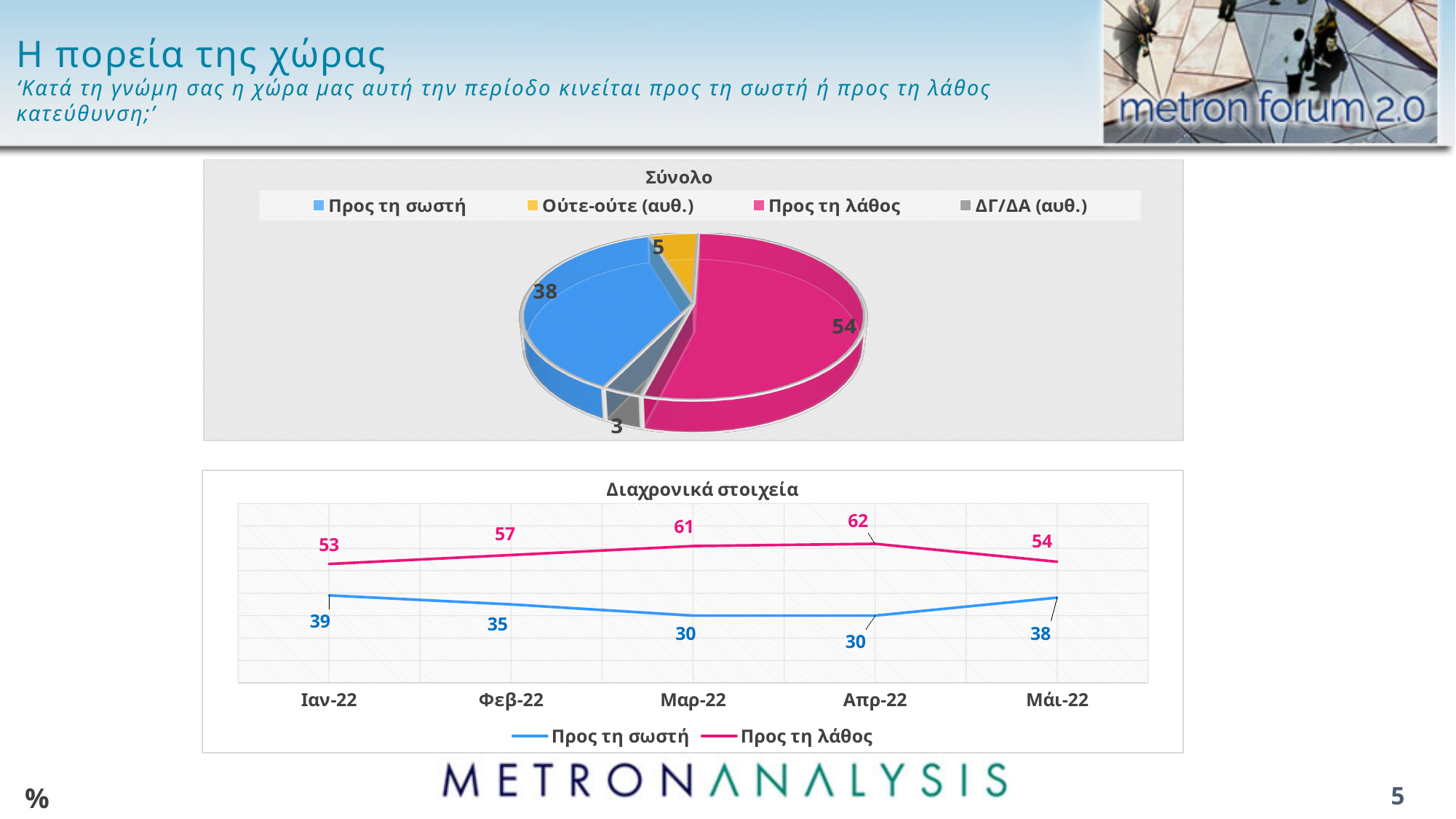
In the 'Διαχρονικά στοιχεία' chart, in which month does 'Προς τη λάθος' reach its highest value? Απρ-22 In the 'Διαχρονικά στοιχεία' chart, what is the value for 'Προς τη λάθος' in Απρ-22? 62 In the 'Διαχρονικά στοιχεία' chart, what is the difference between 'Προς τη λάθος' and 'Προς τη σωστή' in Μαρ-22? 31 In the 'Σύνολο' pie chart, which category has the smallest slice? ΔΓ/ΔΑ (αυθ.) In the 'Σύνολο' pie chart, what is the value for 'Ούτε-ούτε (αυθ.)'? 5 How many categories does the legend of the 'Σύνολο' pie chart list? 4 How many time points are shown on the x axis of the 'Διαχρονικά στοιχεία' chart? 5 In the 'Σύνολο' pie chart, which category has the largest slice? Προς τη λάθος In the 'Σύνολο' pie chart, what is the difference between 'Προς τη λάθος' and 'Προς τη σωστή'? 16 In the 'Σύνολο' pie chart, what is the value for 'Προς τη λάθος'? 54 What type of chart is 'Διαχρονικά στοιχεία'? Line chart In the 'Διαχρονικά στοιχεία' chart, what is the value for 'Προς τη σωστή' in Φεβ-22? 35